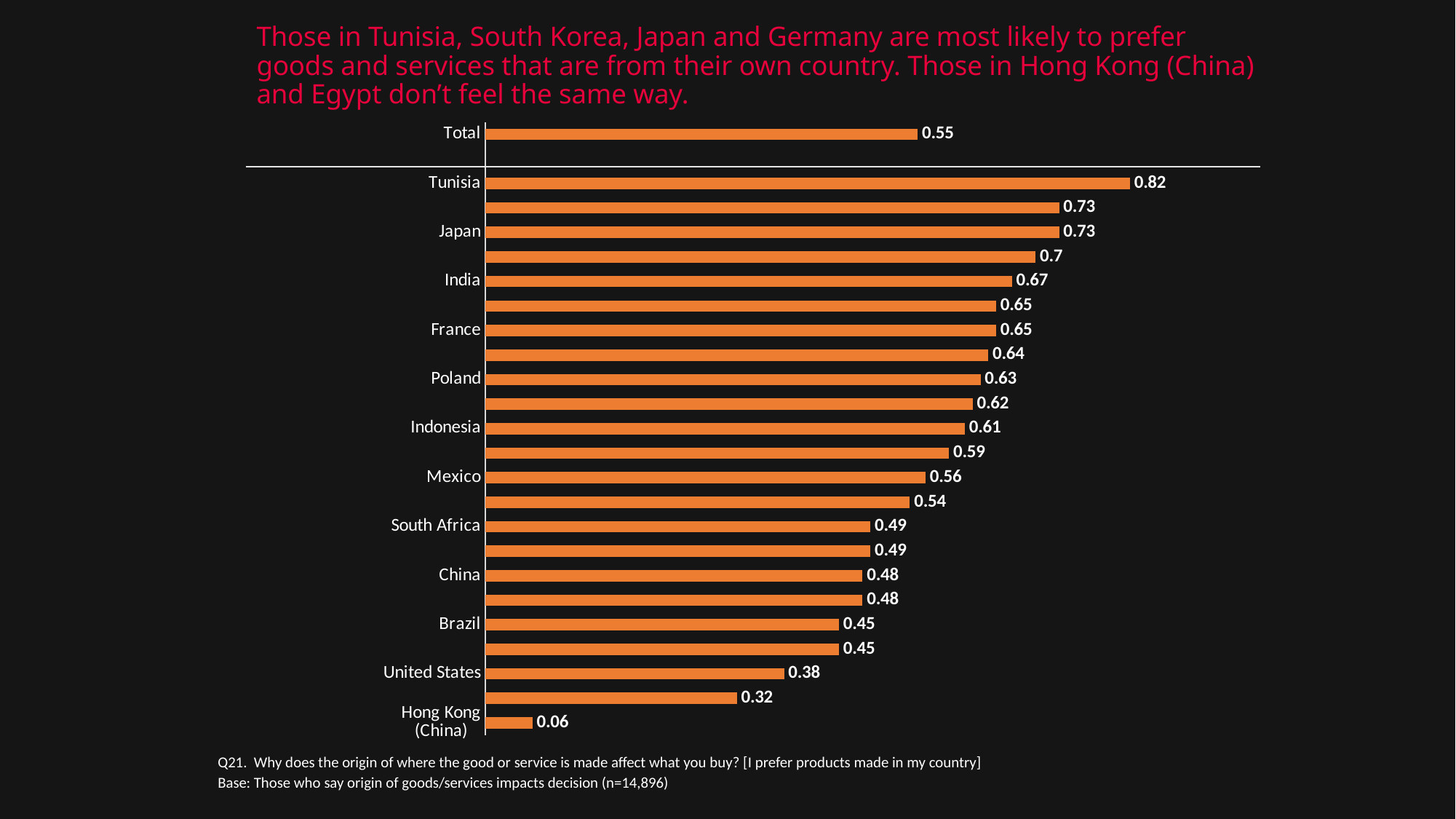
Which country has the lowest value? Hong Kong (China) What colour are the bars in the chart? Orange Which country has the highest value? Tunisia What is the value for United States? 0.38 What is the difference between the values for Tunisia and Hong Kong (China)? 0.76 What kind of chart is shown on the slide? Bar chart What is the value for Hong Kong (China)? 0.06 What is the value for Total? 0.55 Which has a larger value, France or Poland? France What is the value for Japan? 0.73 What is the value for Tunisia? 0.82 What is the value for Indonesia? 0.61